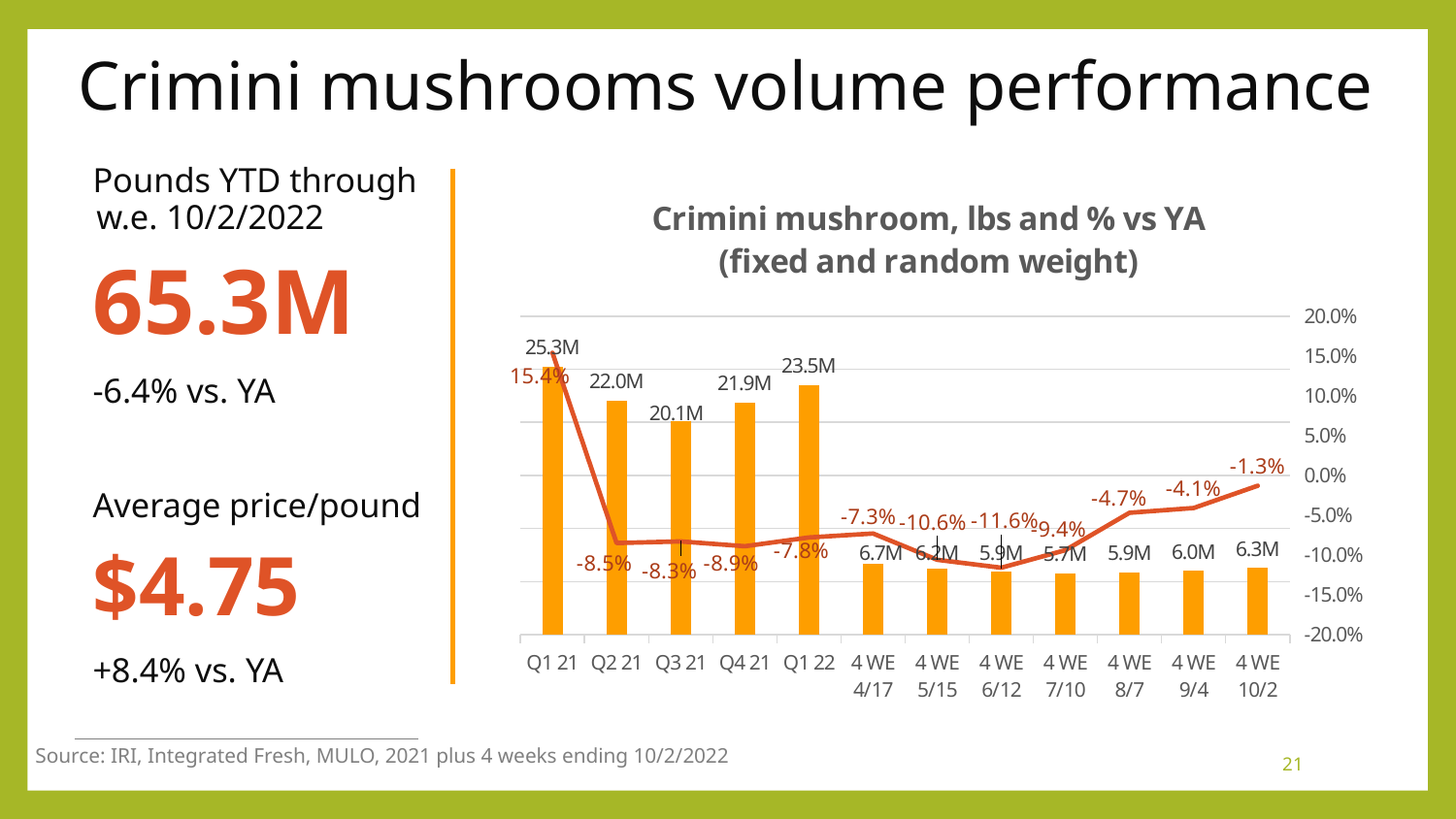
What is the lbs value for Q1 21? 25.3M What is the % vs YA value for the 4 WE 10/2 period? -1.3% Which period has the highest lbs value? Q1 21 Which has a higher lbs value, Q2 21 or Q3 21? Q2 21 What is the % vs YA value for Q1 21? 15.4% Which period has the lowest % vs YA value? 4 WE 6/12 What is the difference in lbs between Q1 21 and Q1 22? 1.8M What is the lbs value for the 4 WE 10/2 period? 6.3M Does the % vs YA line rise or fall from 4 WE 6/12 to 4 WE 10/2? Rise How many periods are shown on the x axis? 12 What kind of chart is this? Combination bar and line chart What is the % vs YA value for Q4 21? -8.9%